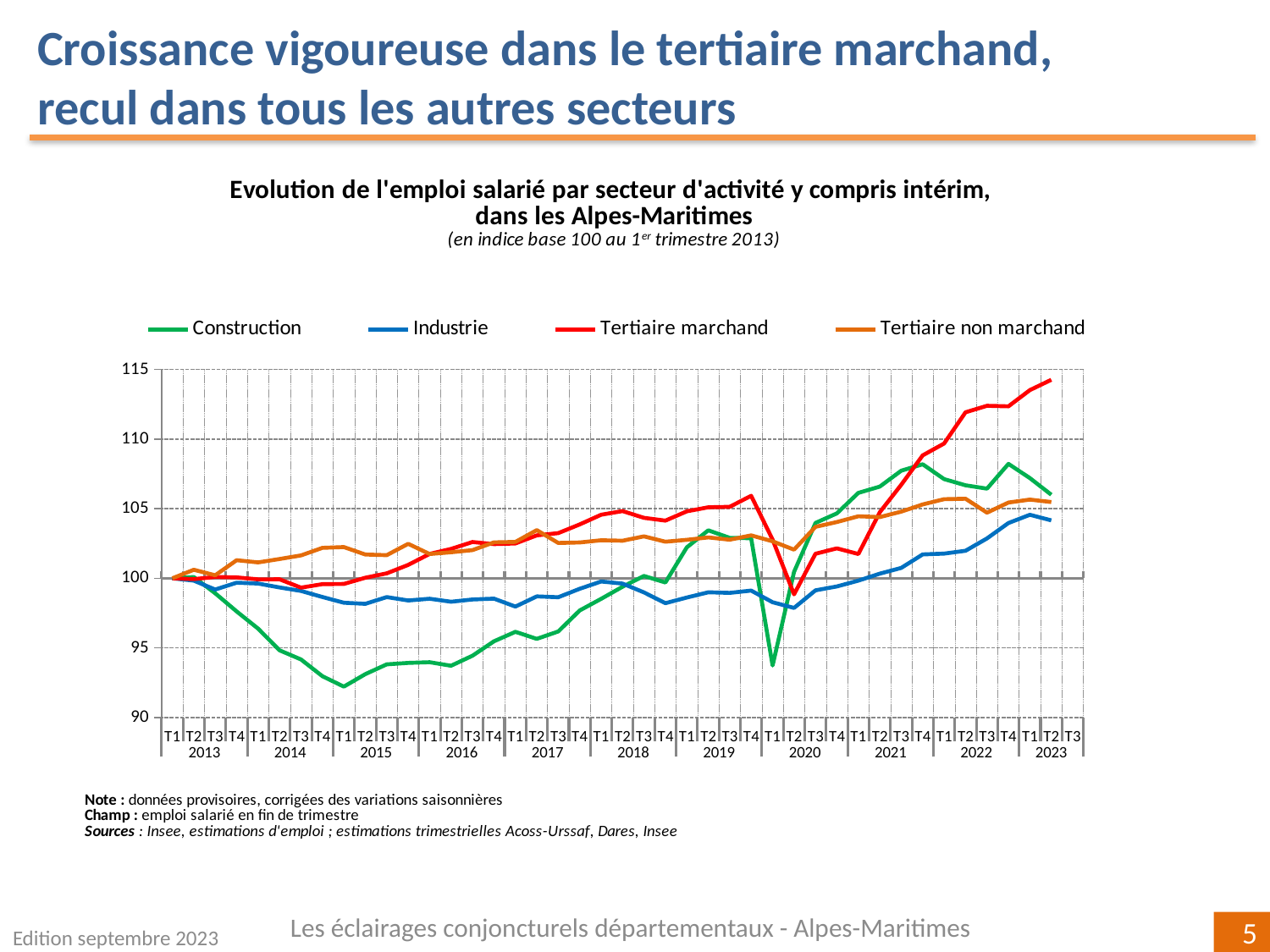
At T1 2020, which is larger: the value for Construction or the value for Industrie? Industrie Which series has the highest value at T2 2023? Tertiaire marchand What kind of chart is shown on the slide? line chart Which series has the lowest value at T1 2015? Construction How many series does the legend list? 4 Is the value for Tertiaire non marchand at T1 2019 greater or less than 100? greater Does the Tertiaire marchand series rise or fall between T1 2021 and T2 2023? rise Is the value for Construction at T1 2015 greater or less than 95? less Is the value for Industrie at T2 2020 greater or less than 100? less What is the index value of all four series at T1 2013? 100 Which series are listed in the legend? Construction, Industrie, Tertiaire marchand, Tertiaire non marchand